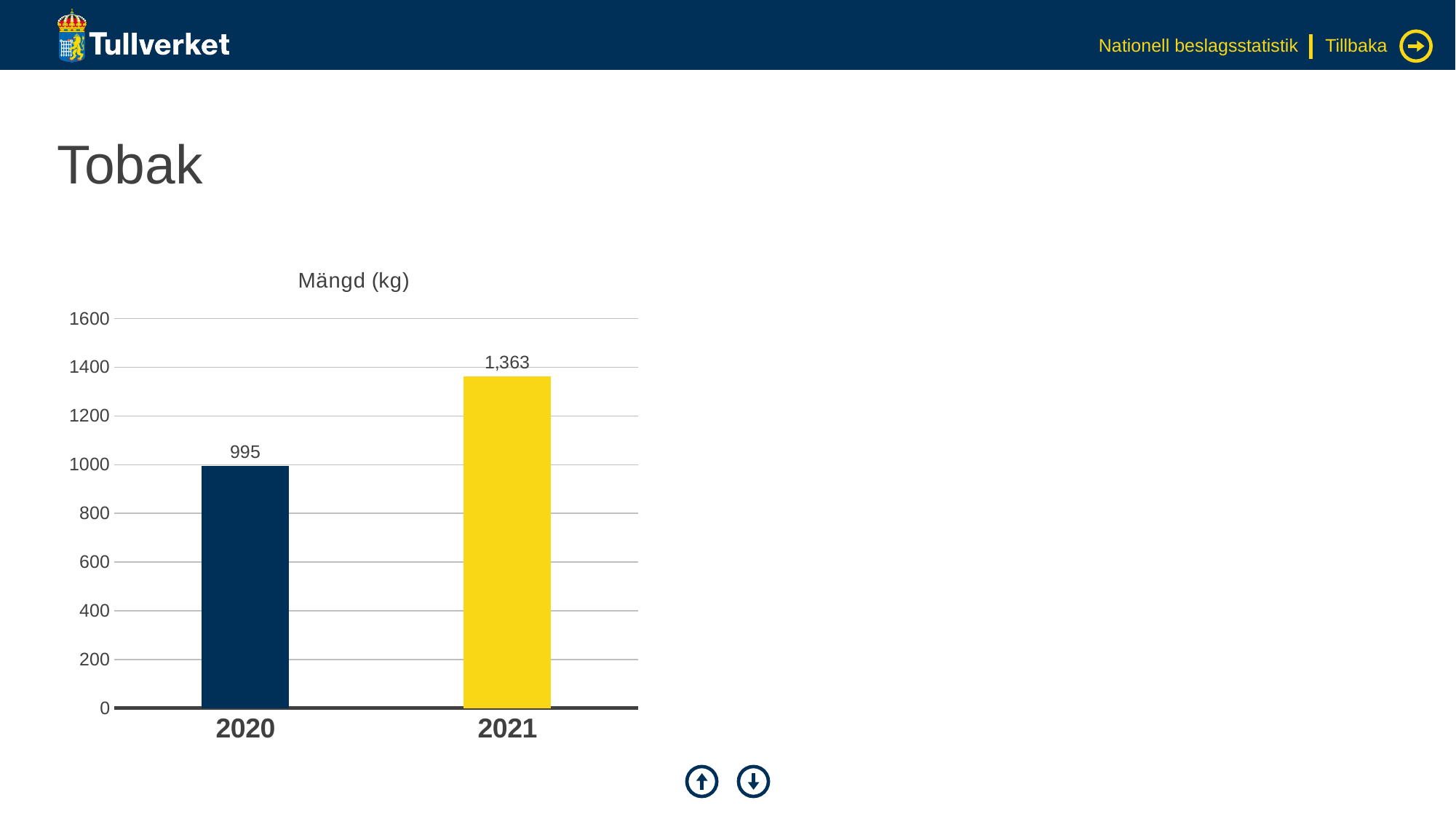
Which is larger in the Mängd (kg) chart, the value for 2020 or the value for 2021? 2021 Which year has the lowest value in the Mängd (kg) chart? 2020 What is the title of the chart on the slide? Mängd (kg) Which year has the highest value in the Mängd (kg) chart? 2021 What is the value for 2020 in the Mängd (kg) chart? 995 Is the value for 2021 greater or less than 1200? greater What is the difference between the 2021 and 2020 values in the Mängd (kg) chart? 368 Is the value for 2020 greater or less than 1000? less How many years are shown in the Mängd (kg) chart? 2 Do the values rise or fall from 2020 to 2021? Rise What kind of chart is shown on the slide? Bar chart What is the value for 2021 in the Mängd (kg) chart? 1,363